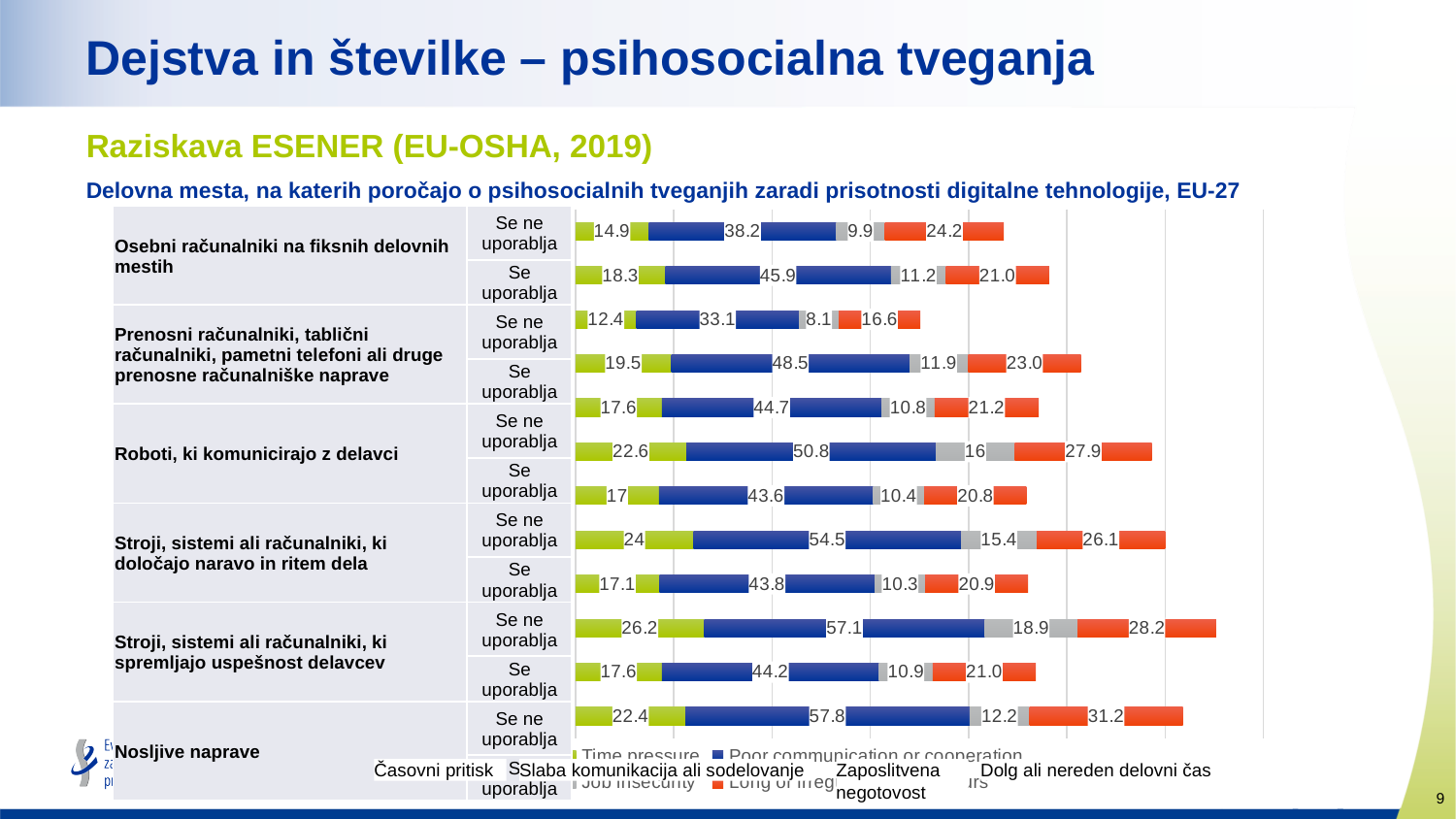
What colour represents Time pressure (Časovni pritisk) in the chart? Green What is the Time pressure (Časovni pritisk) value for 'Osebni računalniki na fiksnih delovnih mestih – Se ne uporablja'? 14.9 What is the difference in Time pressure between 'Se uporablja' (18.3) and 'Se ne uporablja' (14.9) for 'Osebni računalniki na fiksnih delovnih mestih'? 3.4 Which bar has the highest Long or irregular working hours value? Nosljive naprave – Se uporablja (31.2) For 'Roboti, ki komunicirajo z delavci', which has the larger Long or irregular working hours value: 'Se uporablja' or 'Se ne uporablja'? Se uporablja What is the Poor communication or cooperation value for 'Nosljive naprave – Se ne uporablja'? 44.2 What is the Job insecurity value for 'Stroji, sistemi ali računalniki, ki spremljajo uspešnost delavcev – Se uporablja'? 18.9 What kind of chart is shown on the slide? Stacked bar chart How many workplace technology categories are listed down the left side of the chart? 6 How many series does the chart's legend list? 4 Which bar has the lowest Time pressure value? Prenosni računalniki, tablični računalniki... – Se ne uporablja (12.4) What is the total of the stacked bar for 'Osebni računalniki na fiksnih delovnih mestih – Se ne uporablja'? 87.2